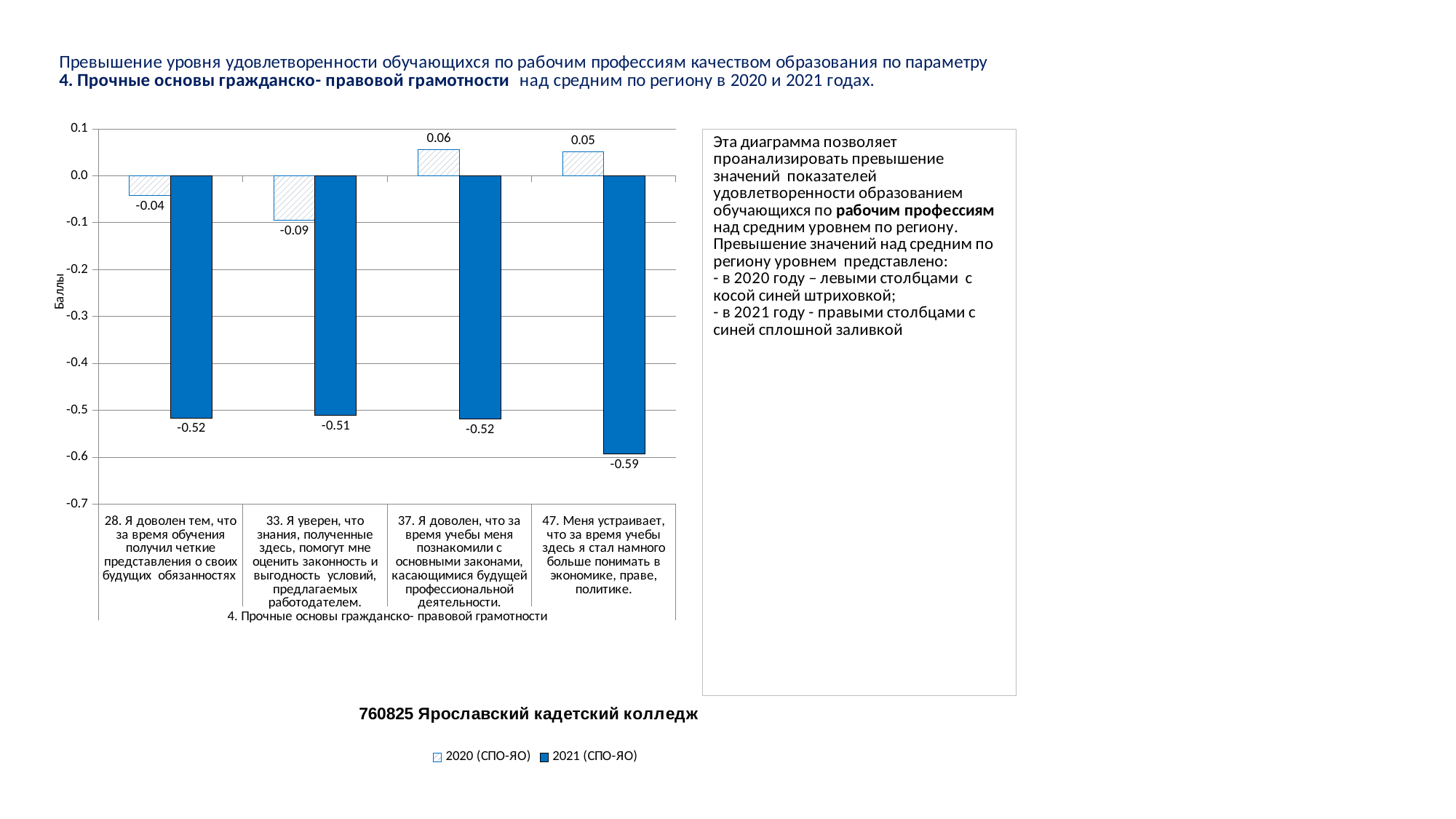
How many categories (questions) are shown along the x axis of the chart? 4 What is the 2020 (СПО-ЯО) value for question 28 (Я доволен тем, что за время обучения получил четкие представления о своих будущих обязанностях)? -0.04 What type of chart is shown on the slide? bar chart What is the 2021 (СПО-ЯО) value for question 47 (Меня устраивает, что за время учебы здесь я стал намного больше понимать в экономике, праве, политике)? -0.59 How many series does the chart legend list? 2 What is the label of the y axis of the chart? Баллы Which category has the highest 2020 (СПО-ЯО) value? 37. Я доволен, что за время учебы меня познакомили с основными законами, касающимися будущей профессиональной деятельности. What is the difference between the 2020 (СПО-ЯО) and 2021 (СПО-ЯО) values for question 33? 0.42 What is the 2020 (СПО-ЯО) value for question 37 (Я доволен, что за время учебы меня познакомили с основными законами)? 0.06 Which series is shown with a hatched (striped) fill in the chart? 2020 (СПО-ЯО) For question 28, which is larger: the 2020 (СПО-ЯО) value or the 2021 (СПО-ЯО) value? 2020 (СПО-ЯО) Which category has the lowest 2021 (СПО-ЯО) value? 47. Меня устраивает, что за время учебы здесь я стал намного больше понимать в экономике, праве, политике.